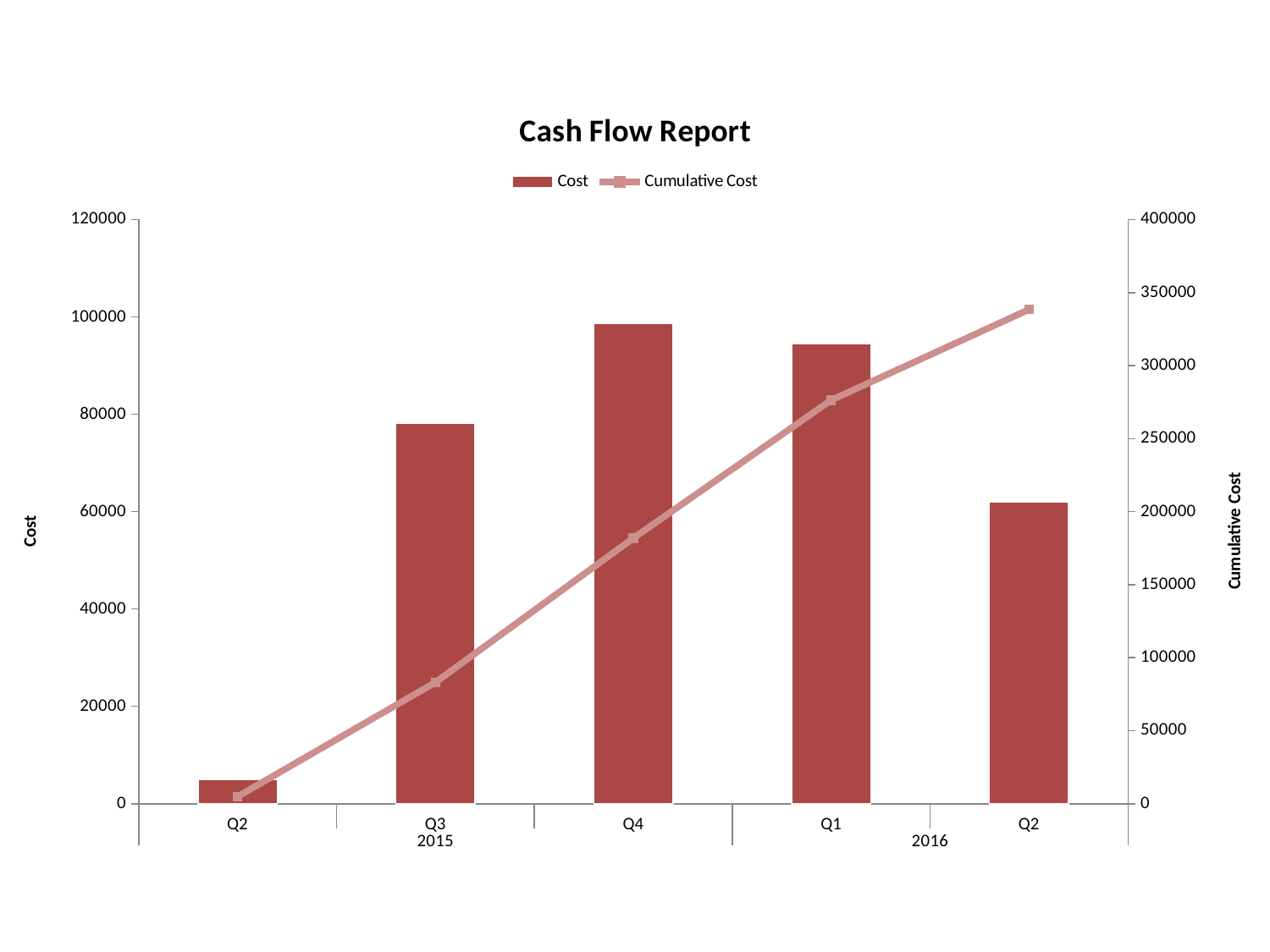
What is the title of the chart? Cash Flow Report Which quarter has the highest Cost bar? Q4 2015 How many series does the legend list? 2 Is the Cost for Q2 2016 greater or less than 80000? less Does the Cumulative Cost line rise or fall from Q2 2015 to Q2 2016? Rises Is the Cumulative Cost for Q4 2015 greater or less than 200000? less Which quarter has the lowest Cost bar? Q2 2015 Is the Cost for Q3 2015 greater or less than 60000? greater What kind of chart is shown on the slide? A combined bar and line chart Which is larger, the Cost for Q3 2015 or the Cost for Q2 2016? Q3 2015 How many quarters are plotted along the x axis? 5